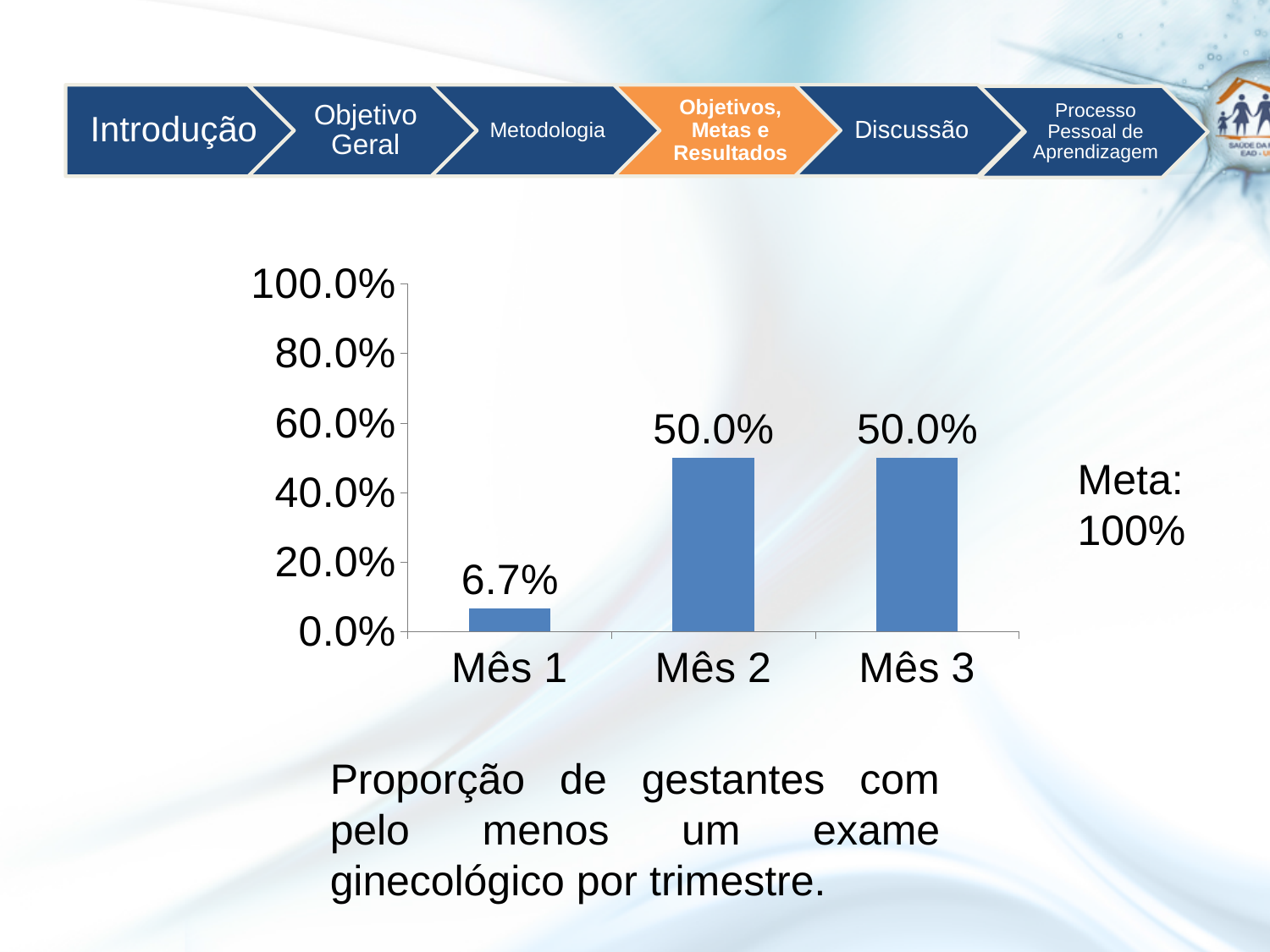
What is the difference between the values for Mês 2 and Mês 1? 43.3% Is the value for Mês 2 greater or less than 40.0%? greater Is the value for Mês 1 greater or less than 20.0%? less Do the values rise or fall from Mês 1 to Mês 2? rise What is the value for Mês 3? 50.0% What is the value for Mês 2? 50.0% What is the value for Mês 1? 6.7% Which is larger, the value for Mês 1 or the value for Mês 3? Mês 3 Which month has the lowest value? Mês 1 What kind of chart is shown on the slide? bar chart What target (Meta) is stated next to the chart? 100% How many categories are shown on the x axis? 3